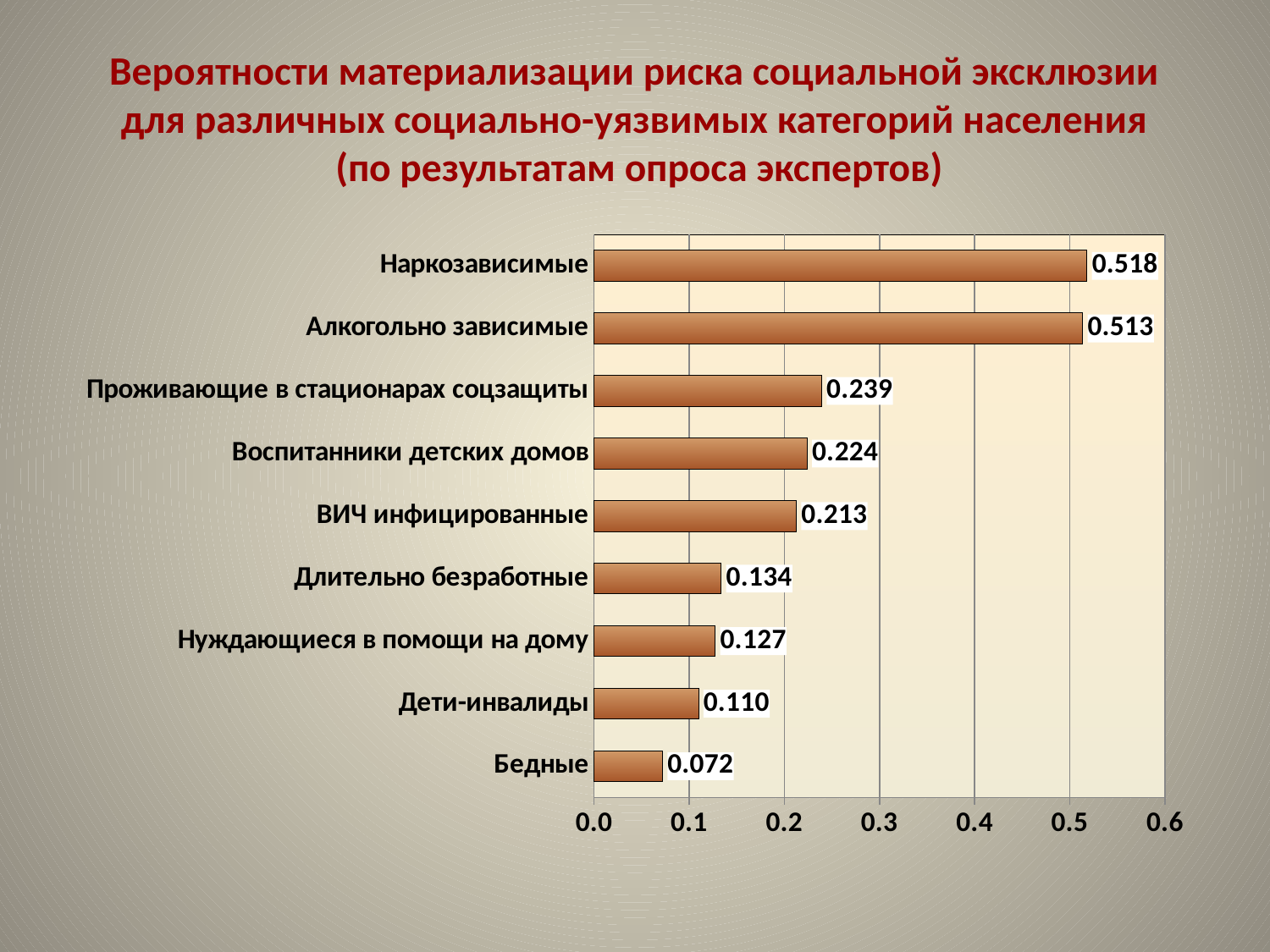
Is the value for Дети-инвалиды greater or less than 0.1? greater What is the maximum value shown on the horizontal axis? 0.6 What is the difference between the values for Наркозависимые and Алкогольно зависимые? 0.005 How many categories are shown in the chart? 9 What is the value for Бедные? 0.072 Which category has the lowest value? Бедные Which category has the highest value? Наркозависимые What is the value for Наркозависимые? 0.518 What is the value for Воспитанники детских домов? 0.224 What kind of chart is shown on the slide? bar chart What is the difference between the values for Проживающие в стационарах соцзащиты and Бедные? 0.167 Which is larger, the value for ВИЧ инфицированные or the value for Длительно безработные? ВИЧ инфицированные